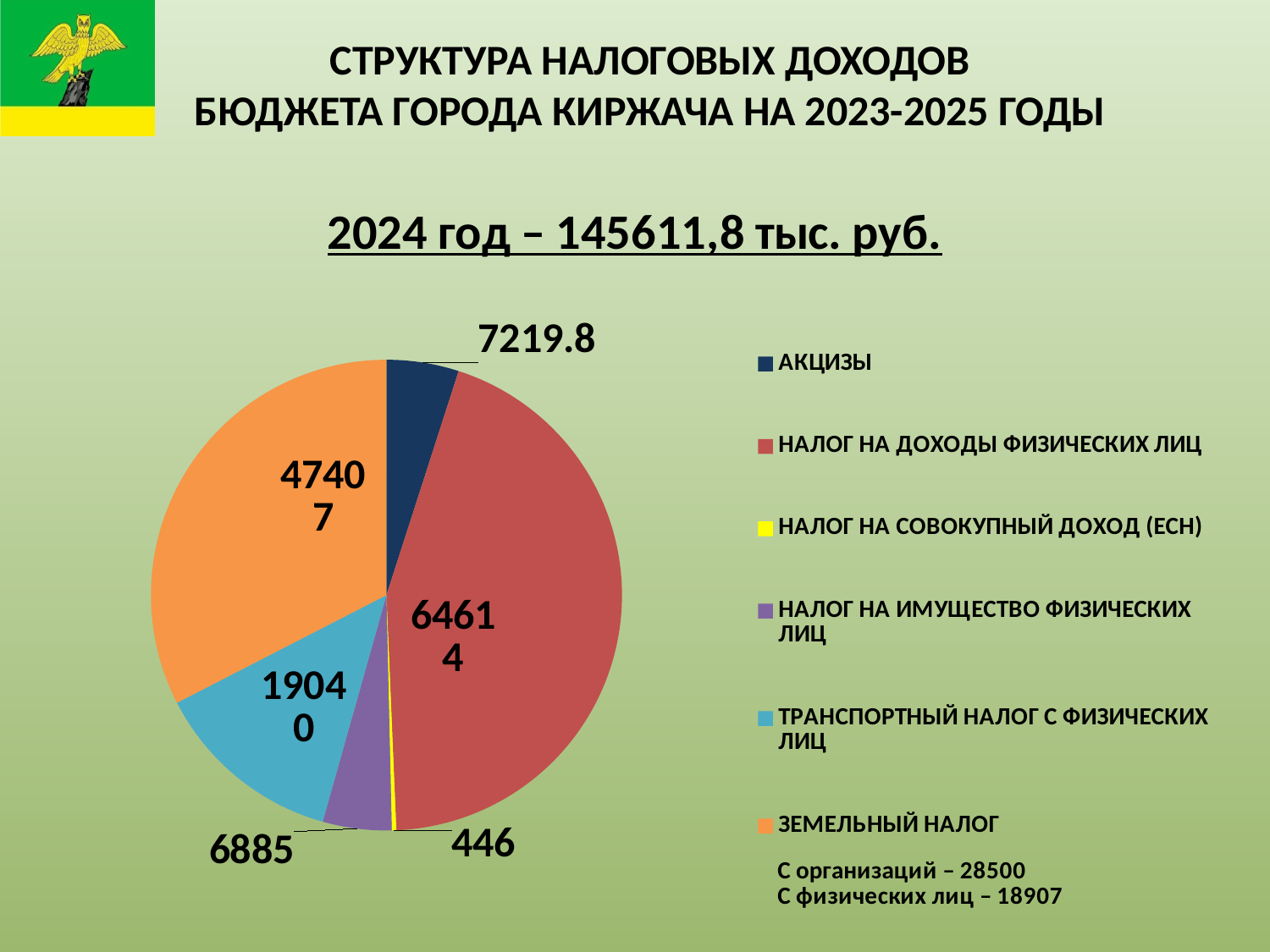
What is the value for НАЛОГ НА СОВОКУПНЫЙ ДОХОД (ЕСН) in the pie chart? 446 Which category has the smallest slice in the pie chart? НАЛОГ НА СОВОКУПНЫЙ ДОХОД (ЕСН) How many categories does the legend of the pie chart list? 6 What is the difference between the values for НАЛОГ НА ДОХОДЫ ФИЗИЧЕСКИХ ЛИЦ and ЗЕМЕЛЬНЫЙ НАЛОГ? 17207 What is the value for НАЛОГ НА ДОХОДЫ ФИЗИЧЕСКИХ ЛИЦ in the pie chart? 64614 What colour is the slice for ЗЕМЕЛЬНЫЙ НАЛОГ in the pie chart? orange What type of chart is shown on the slide? pie chart What is the value for ЗЕМЕЛЬНЫЙ НАЛОГ in the pie chart? 47407 Which is larger: ТРАНСПОРТНЫЙ НАЛОГ С ФИЗИЧЕСКИХ ЛИЦ or НАЛОГ НА ИМУЩЕСТВО ФИЗИЧЕСКИХ ЛИЦ? ТРАНСПОРТНЫЙ НАЛОГ С ФИЗИЧЕСКИХ ЛИЦ Which category has the largest slice in the pie chart? НАЛОГ НА ДОХОДЫ ФИЗИЧЕСКИХ ЛИЦ What is the value for АКЦИЗЫ in the pie chart? 7219.8 What is the value for ТРАНСПОРТНЫЙ НАЛОГ С ФИЗИЧЕСКИХ ЛИЦ in the pie chart? 19040